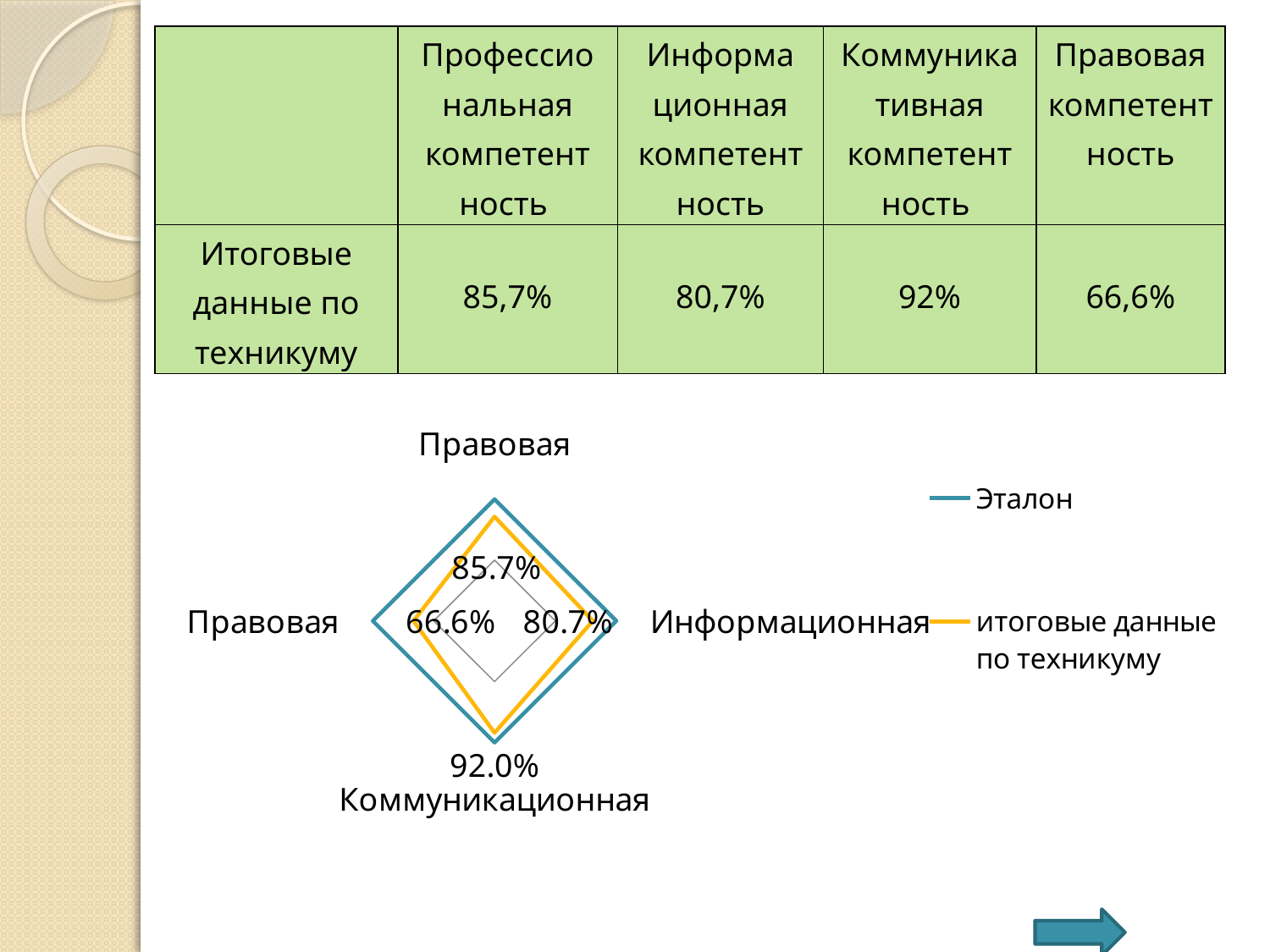
What is the value labelled on the Коммуникационная axis of the radar chart? 92.0% What are the two series named in the chart legend? Эталон; итоговые данные по техникуму Which is larger on the radar chart: the Информационная value or the Коммуникационная value? Коммуникационная What is the difference between the Коммуникационная value (92.0%) and the Информационная value (80.7%) on the radar chart? 11.3 percentage points What is the value labelled on the left-hand axis (Правовая) of the radar chart? 66.6% What is the lowest value labelled on the radar chart? 66.6% What is the value labelled on the top axis of the radar chart? 85.7% What type of chart is shown on the slide? Radar chart How many axes (categories) does the radar chart have? 4 How many series does the chart legend list? 2 Which axis of the radar chart has the highest labelled value? Коммуникационная What is the value labelled on the Информационная axis of the radar chart? 80.7%